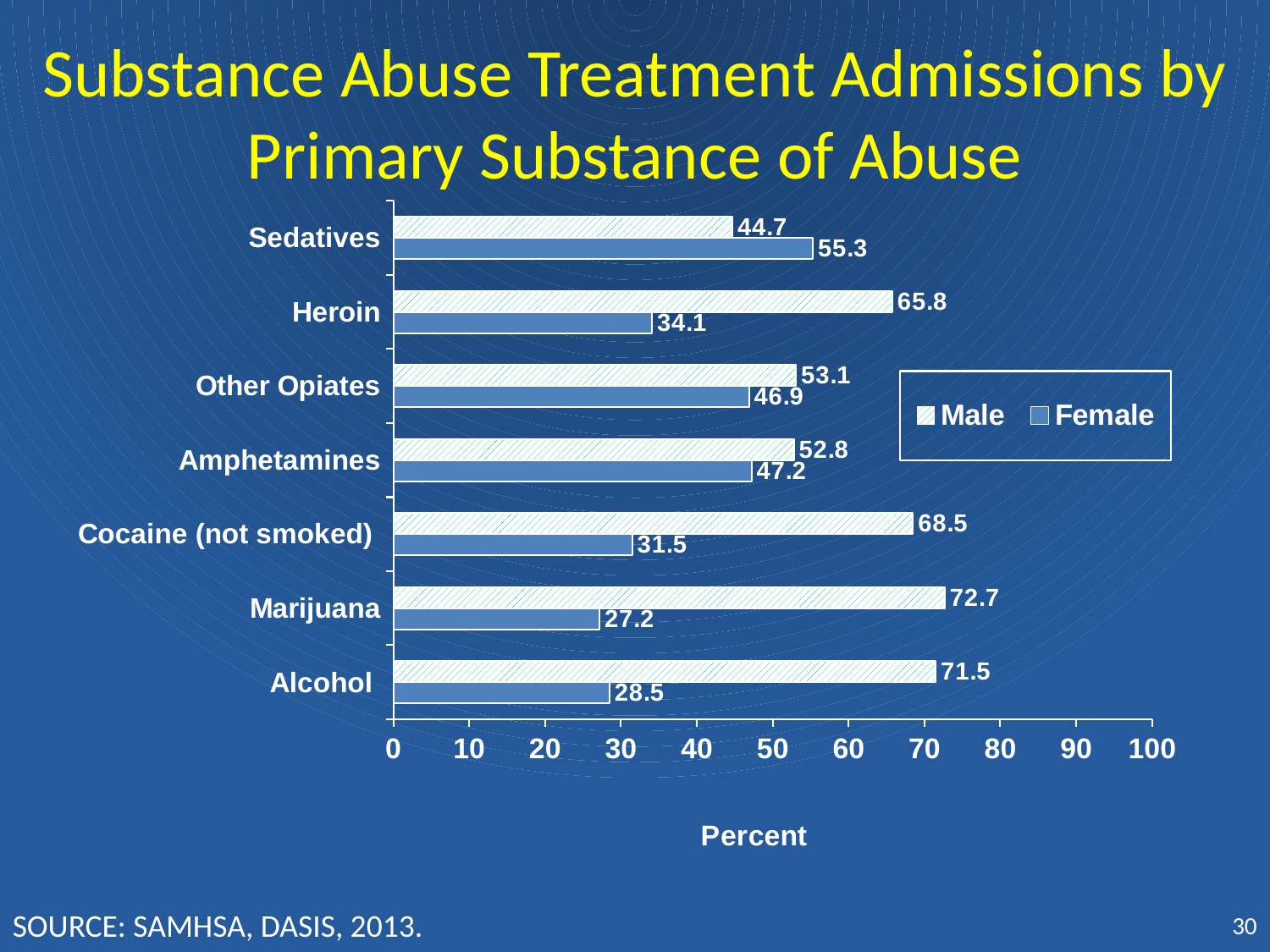
How many series does the legend list? 2 What is the Female value for Heroin? 34.1 What is the Male value for Marijuana? 72.7 How many categories are shown on the chart? 7 What is the difference between the Male and Female values for Alcohol? 43 Which category has the lowest Female value? Marijuana What is the label of the horizontal axis? Percent Which is larger, the Male value for Other Opiates or the Male value for Cocaine (not smoked)? Cocaine (not smoked) What is the Female value for Sedatives? 55.3 What kind of chart is shown on the slide? Bar chart Which category has the lowest Male value? Sedatives Which category has the highest Male value? Marijuana